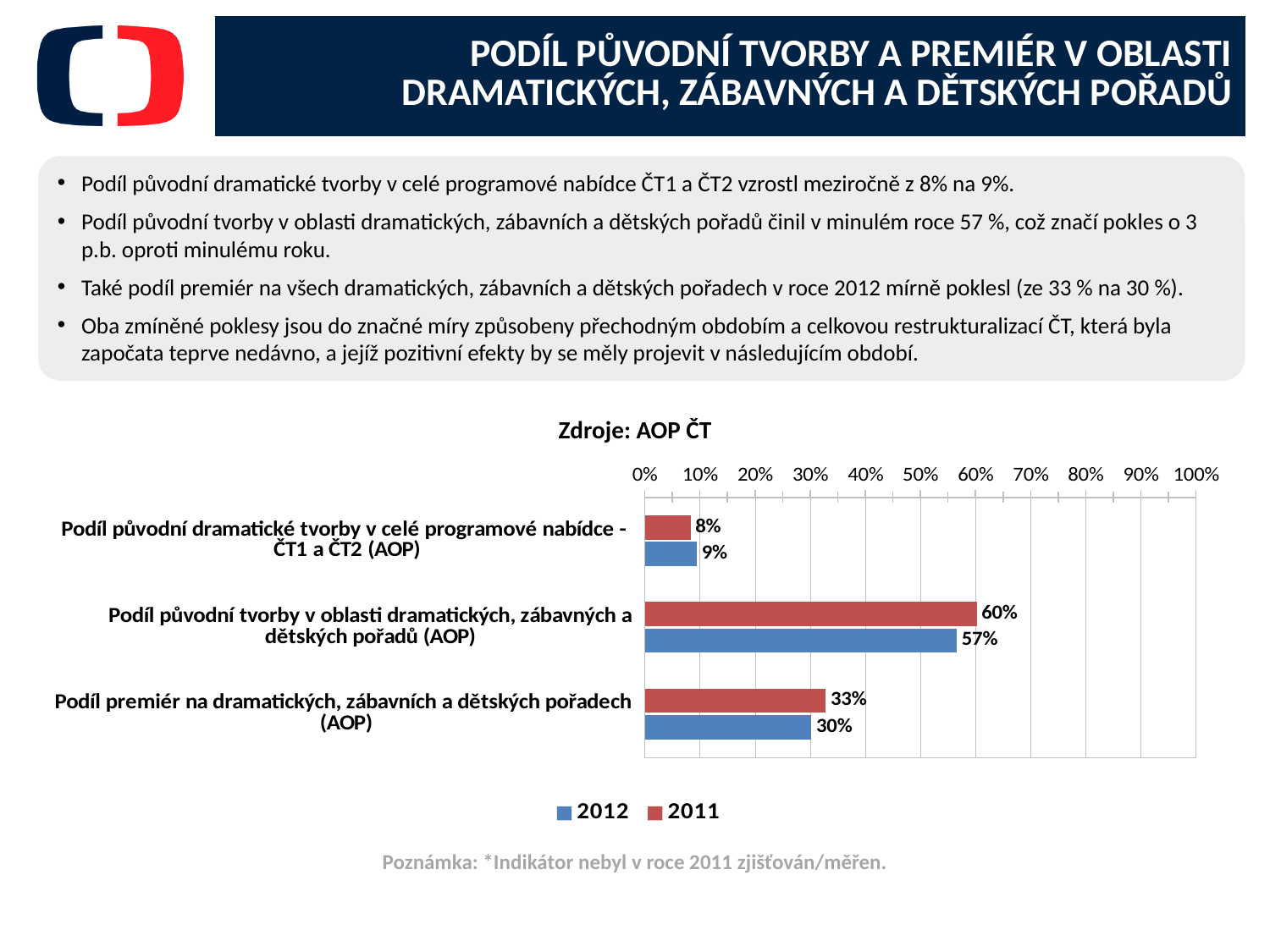
What is the difference between the 2011 and 2012 values for 'Podíl původní tvorby v oblasti dramatických, zábavných a dětských pořadů (AOP)'? 3% What is the 2012 value for 'Podíl původní dramatické tvorby v celé programové nabídce - ČT1 a ČT2 (AOP)'? 9% What is the 2011 value for 'Podíl premiér na dramatických, zábavních a dětských pořadech (AOP)'? 33% For 'Podíl premiér na dramatických, zábavních a dětských pořadech (AOP)', which year has the larger value, 2011 or 2012? 2011 What is the 2012 value for 'Podíl původní tvorby v oblasti dramatických, zábavných a dětských pořadů (AOP)'? 57% What is the source given above the chart? AOP ČT What kind of chart is shown on the slide? bar chart How many categories are shown on the chart? 3 How many series does the legend list? 2 Which category has the lowest 2012 value? Podíl původní dramatické tvorby v celé programové nabídce - ČT1 a ČT2 (AOP) Which category has the highest 2011 value? Podíl původní tvorby v oblasti dramatických, zábavných a dětských pořadů (AOP) Is the 2012 value for 'Podíl původní tvorby v oblasti dramatických, zábavných a dětských pořadů (AOP)' greater or less than 50%? greater